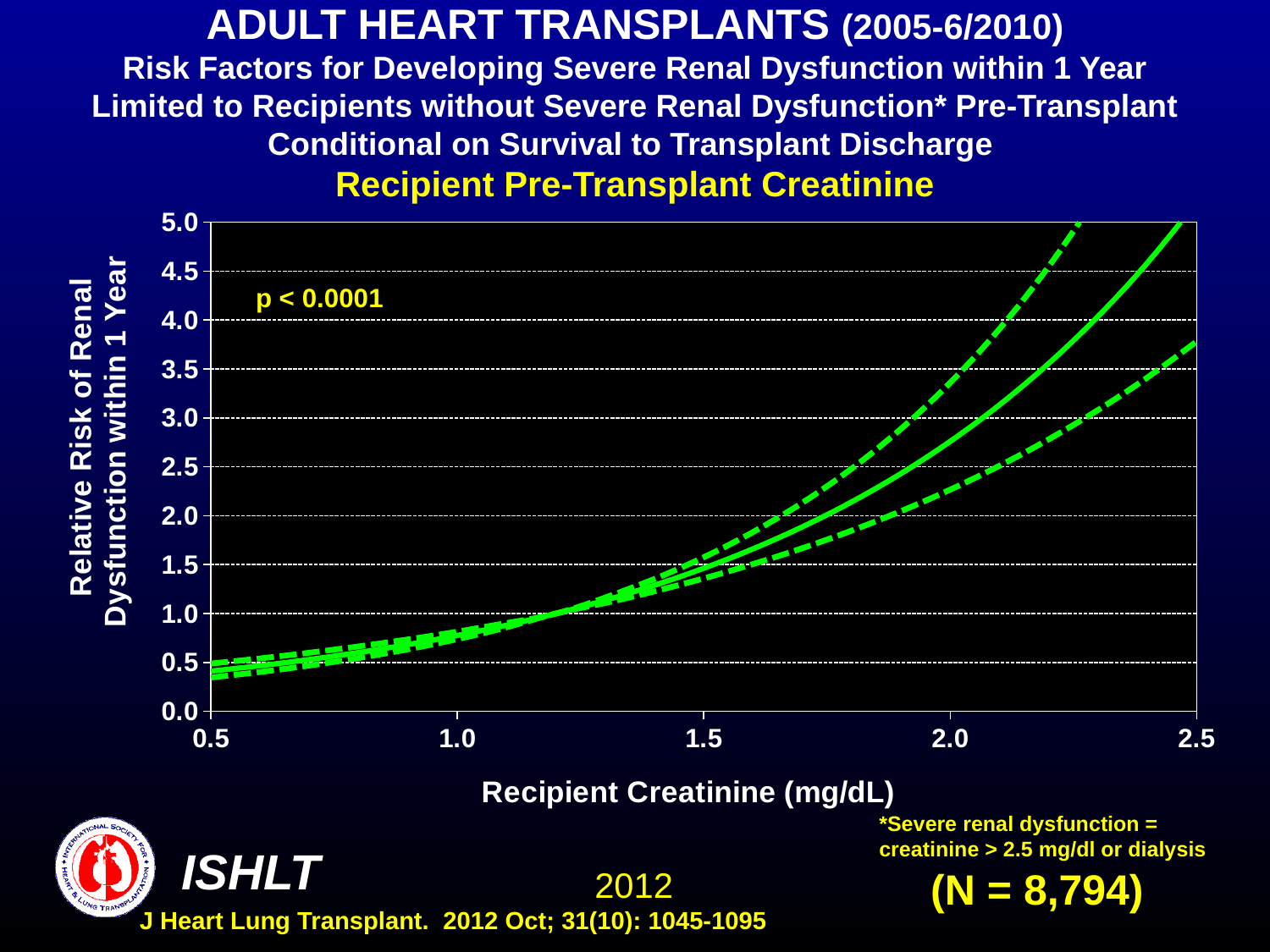
Is the value of the solid line at a recipient creatinine of 1.5 mg/dL greater or less than 1.0? greater Does the relative risk of renal dysfunction rise or fall as recipient creatinine increases along the x axis? rise How many lines (solid and dashed) are plotted on the chart? 3 What is the highest value shown on the y axis? 5.0 Is the value of the solid line at a recipient creatinine of 1.0 mg/dL greater or less than 1.0? less What p-value is printed on the chart? p < 0.0001 Is the value of the solid line at a recipient creatinine of 1.5 mg/dL greater or less than 2.0? less What kind of chart is shown on the slide? line chart What is the label of the x axis? Recipient Creatinine (mg/dL) What is the lowest recipient creatinine value shown on the x axis? 0.5